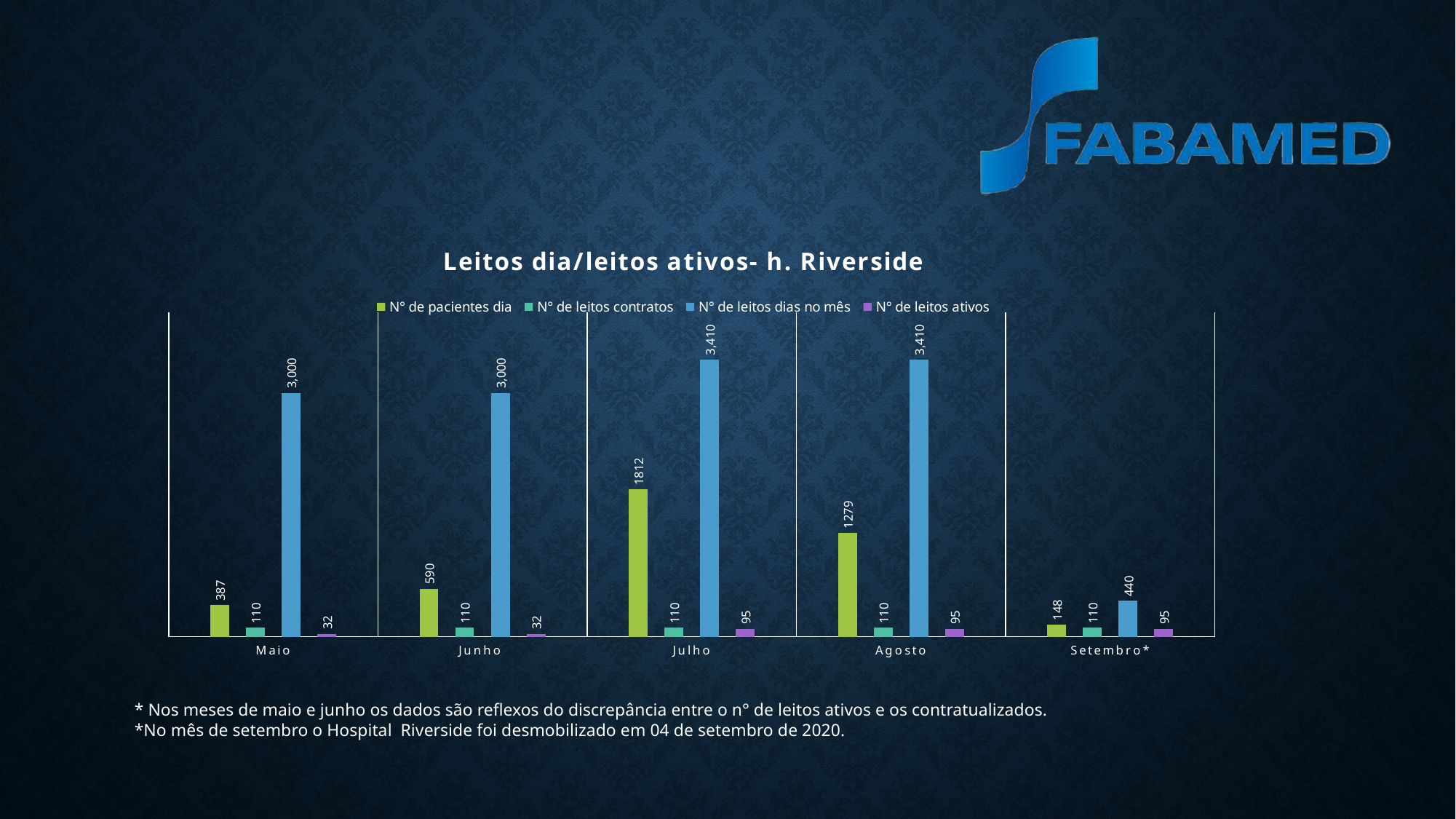
What is the value of N° de leitos dias no mês for Setembro*? 440 Which month has the highest value for N° de pacientes dia? Julho How many series does the legend list? 4 What is the value of N° de leitos dias no mês for Maio? 3,000 What is the value of N° de pacientes dia for Julho? 1812 Which is larger: N° de pacientes dia in Junho or in Maio? Junho How many months are shown on the x axis? 5 Which month has the lowest value for N° de pacientes dia? Setembro* What kind of chart is shown on the slide? Bar chart What is the title of the chart? Leitos dia/leitos ativos- h. Riverside What is the value of N° de leitos ativos for Junho? 32 What is the difference between N° de pacientes dia in Julho and in Agosto? 533